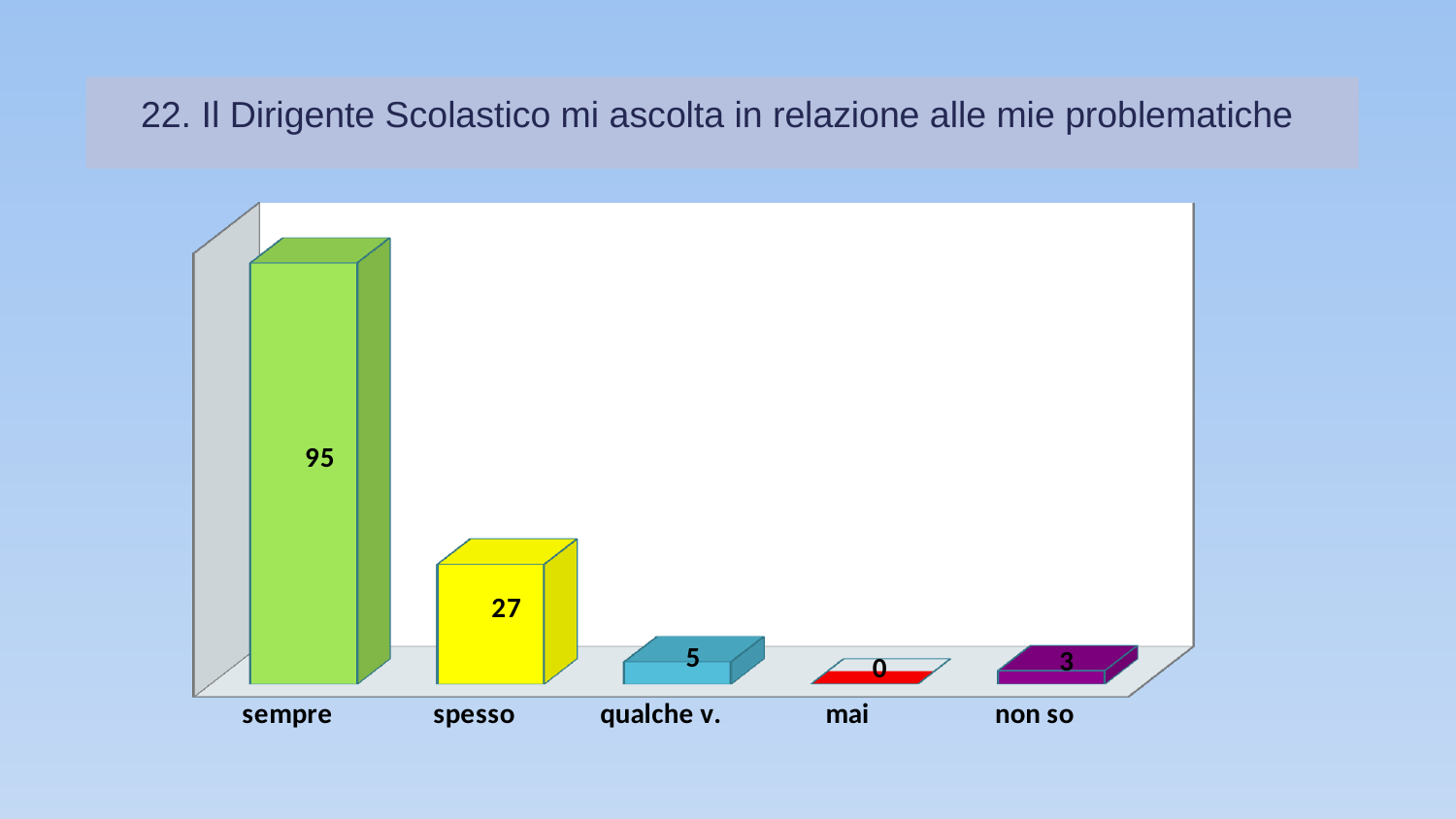
What is the value for "qualche v."? 5 Which category has the highest value? sempre What is the value for "sempre"? 95 What is the value for "mai"? 0 What kind of chart is shown on the slide? bar chart What is the difference between the values for "sempre" and "spesso"? 68 Which category has the lowest value? mai How many categories are shown on the x axis? 5 What is the value for "spesso"? 27 What is the value for "non so"? 3 What colour is the bar for "spesso"? yellow Which is larger, the value for "qualche v." or the value for "non so"? qualche v.